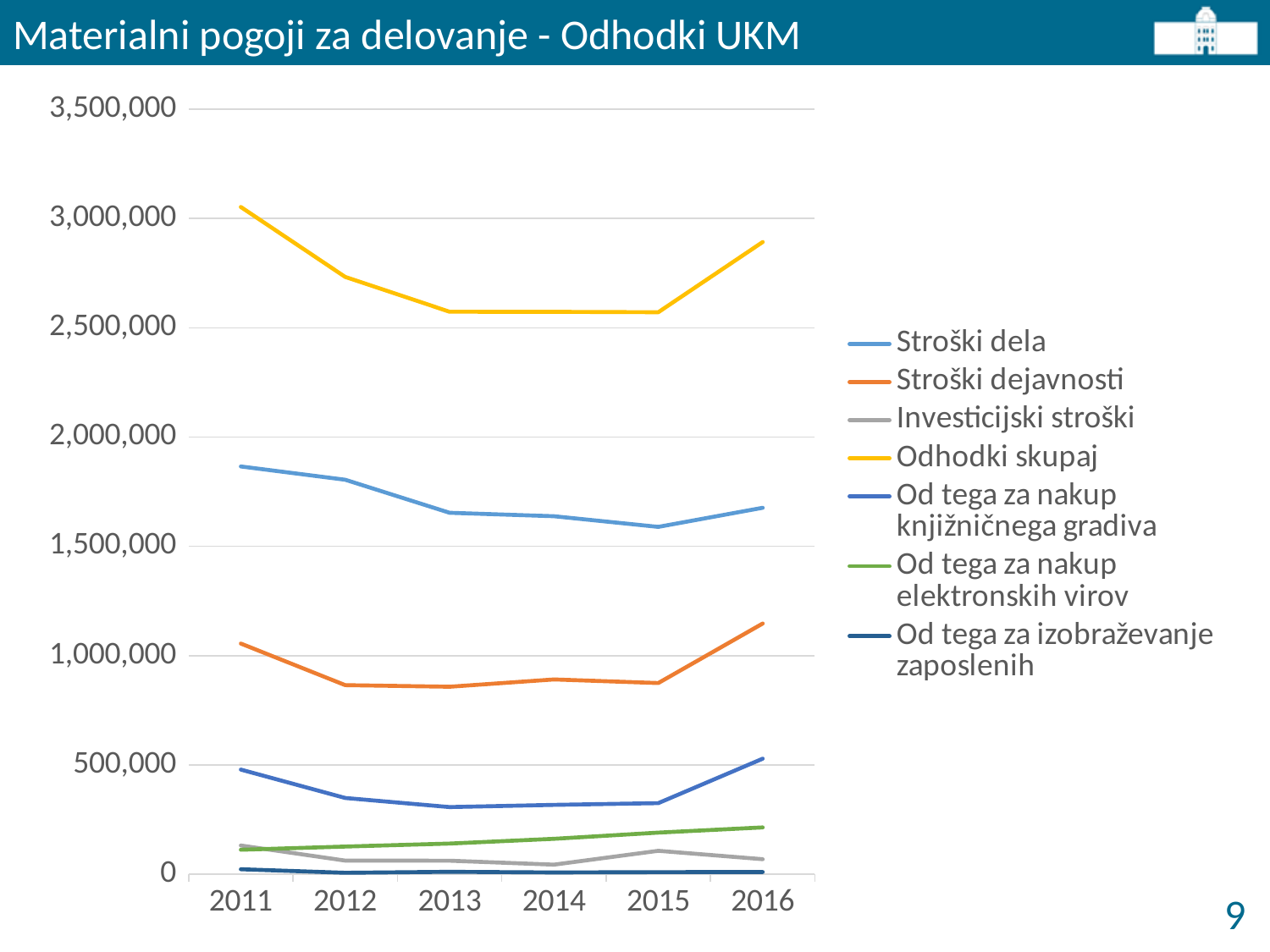
How many years are shown on the x axis? 6 How many series does the legend list? 7 What type of chart is shown on the slide? line chart Does the series Od tega za nakup elektronskih virov rise or fall from 2011 to 2016? rises Is the value for Stroški dela in 2011 greater or less than 1,500,000? greater Is the value for Odhodki skupaj in 2016 greater or less than 3,000,000? less Is the value for Stroški dejavnosti in 2012 greater or less than 1,000,000? less In which year is Stroški dela at its lowest? 2015 Which series has the highest values across all years? Odhodki skupaj In 2016, which is larger: Stroški dela or Stroški dejavnosti? Stroški dela What is the title of the slide? Materialni pogoji za delovanje - Odhodki UKM